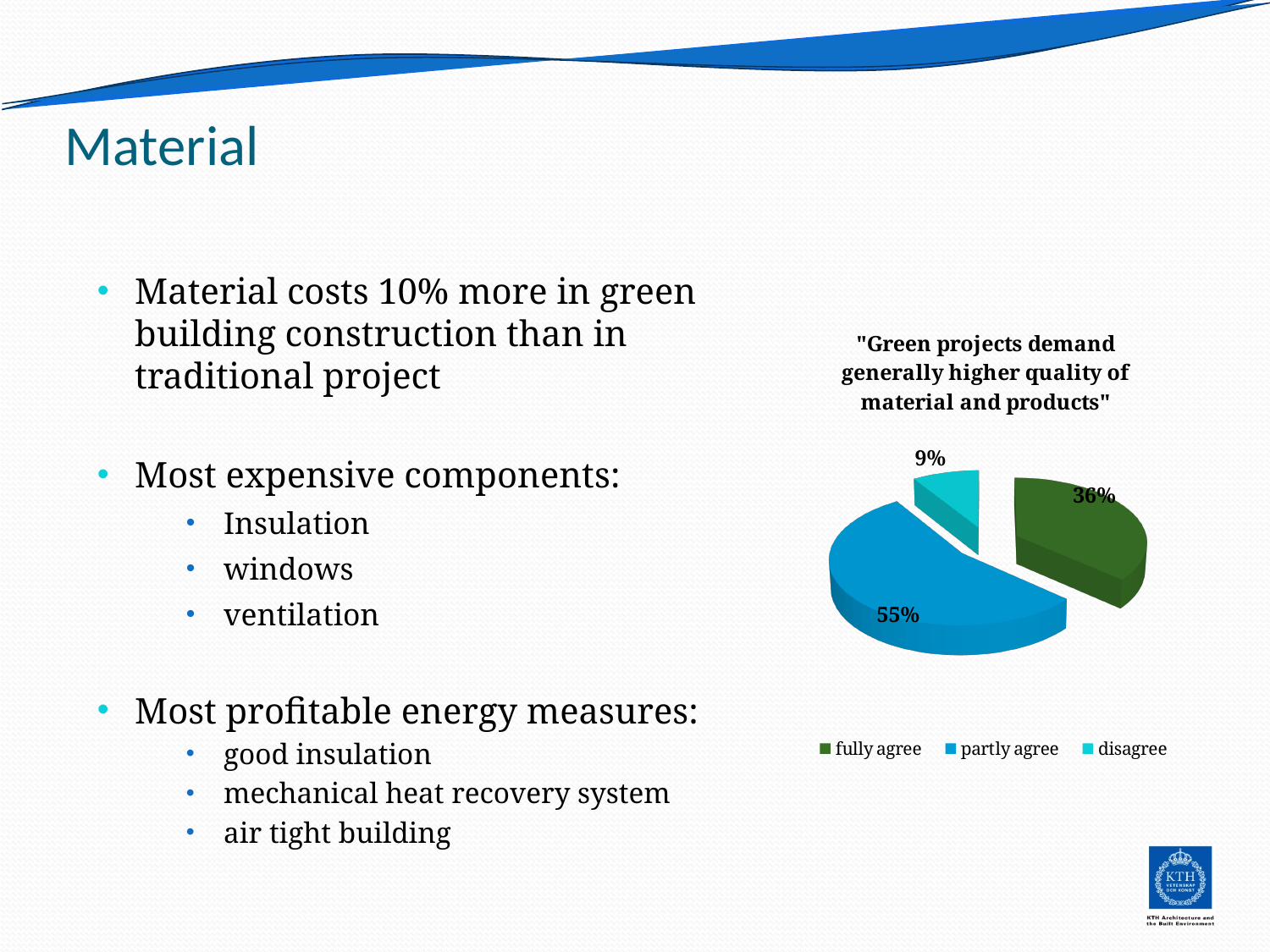
What is the title of the pie chart? "Green projects demand generally higher quality of material and products" Which response has the smallest share of the pie? disagree What percentage of respondents disagree? 9% What is the difference between the share for fully agree and the share for disagree? 27% How many categories does the pie chart show? 3 Which response has the largest share of the pie? partly agree What is the difference between the share for partly agree and the share for fully agree? 19% Which colour represents the disagree slice in the legend? light blue (cyan) What kind of chart is shown on the slide? pie chart What percentage of respondents fully agree? 36% What percentage of respondents partly agree? 55% Which is larger, the share for fully agree or the share for disagree? fully agree